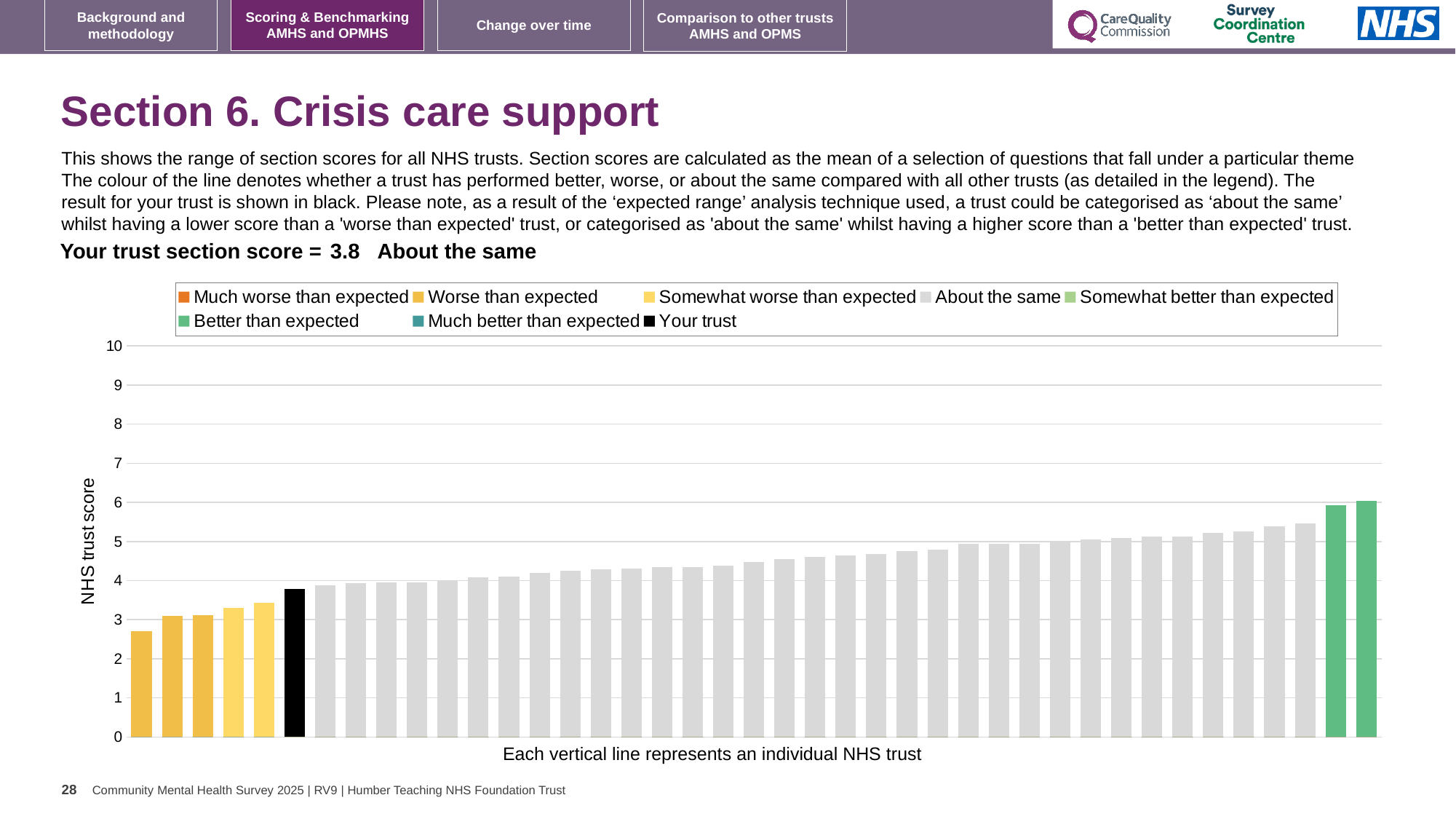
How many green bars are there in the chart? 2 Is the value of the leftmost bar greater or less than 3? less How many black bars are there in the chart? 1 Is the value of the black 'Your trust' bar greater or less than 4? less Which category is your trust's section score placed in, according to the slide? About the same Is the value of the rightmost bar greater or less than 5? greater What is the label on the vertical axis of the chart? NHS trust score What kind of chart is shown on the slide? bar chart What is the section score for your trust shown on the slide? 3.8 What does the text below the horizontal axis say each vertical line represents? an individual NHS trust Do the bar values rise or fall from left to right across the chart? rise How many entries does the chart legend list? 8